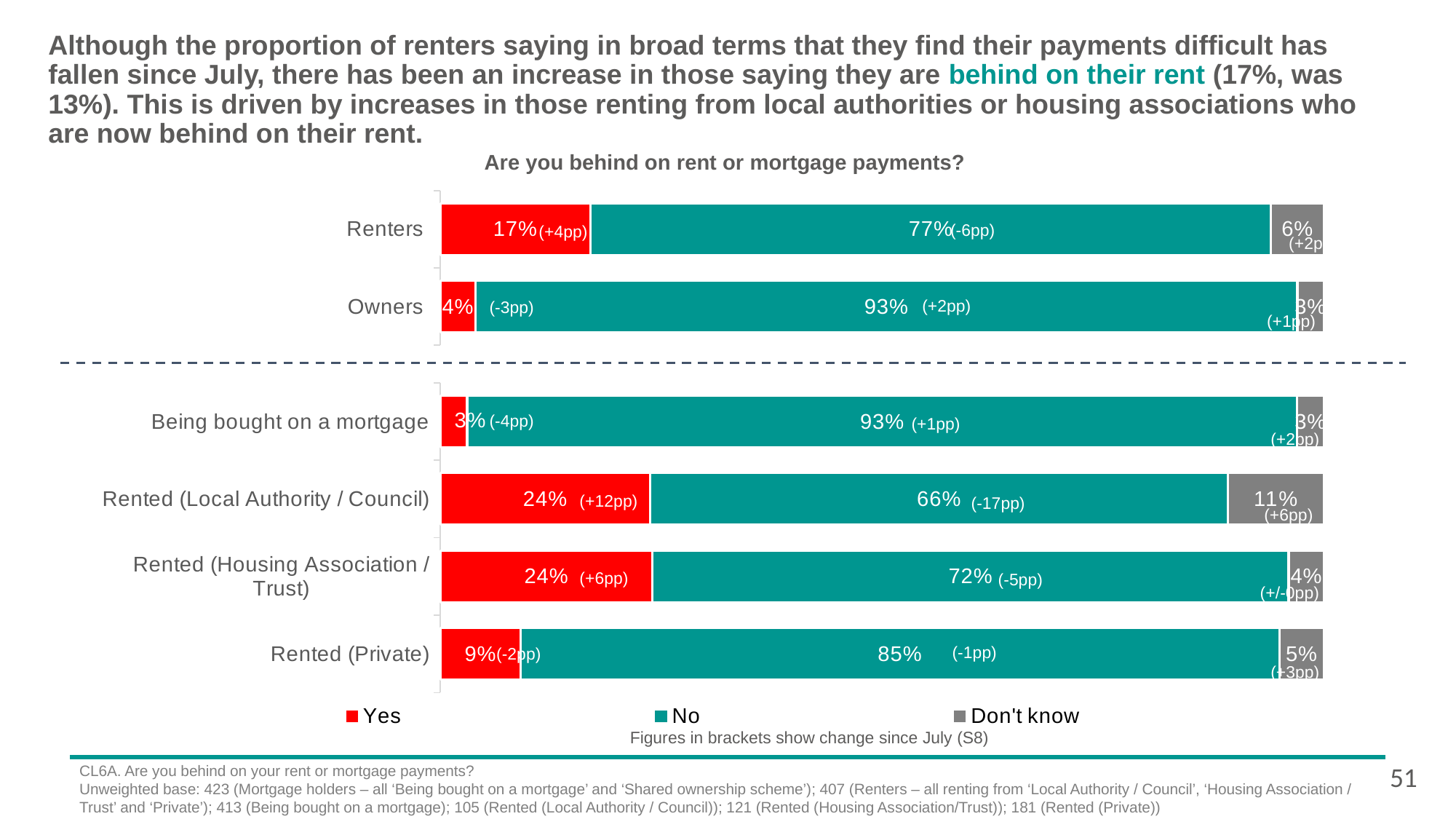
What is the 'Don't know' value for Rented (Local Authority / Council)? 11% What is the 'No' value for Rented (Local Authority / Council)? 66% What is the 'Yes' value for Rented (Private)? 9% What is the difference between the 'Yes' values for Renters and Owners? 13 percentage points What kind of chart is shown on the slide? Stacked bar chart How many categories are shown in the chart? 6 Which is larger, the 'No' value for Rented (Housing Association / Trust) or for Rented (Local Authority / Council)? Rented (Housing Association / Trust) What is the title of the chart? Are you behind on rent or mortgage payments? Which category has the lowest 'Yes' value? Being bought on a mortgage Which category has the highest 'No' value among the renter categories (Local Authority / Council, Housing Association / Trust, Private)? Rented (Private) How many series does the legend list? 3 What percentage of Renters answered 'Yes' to being behind on rent or mortgage payments? 17%